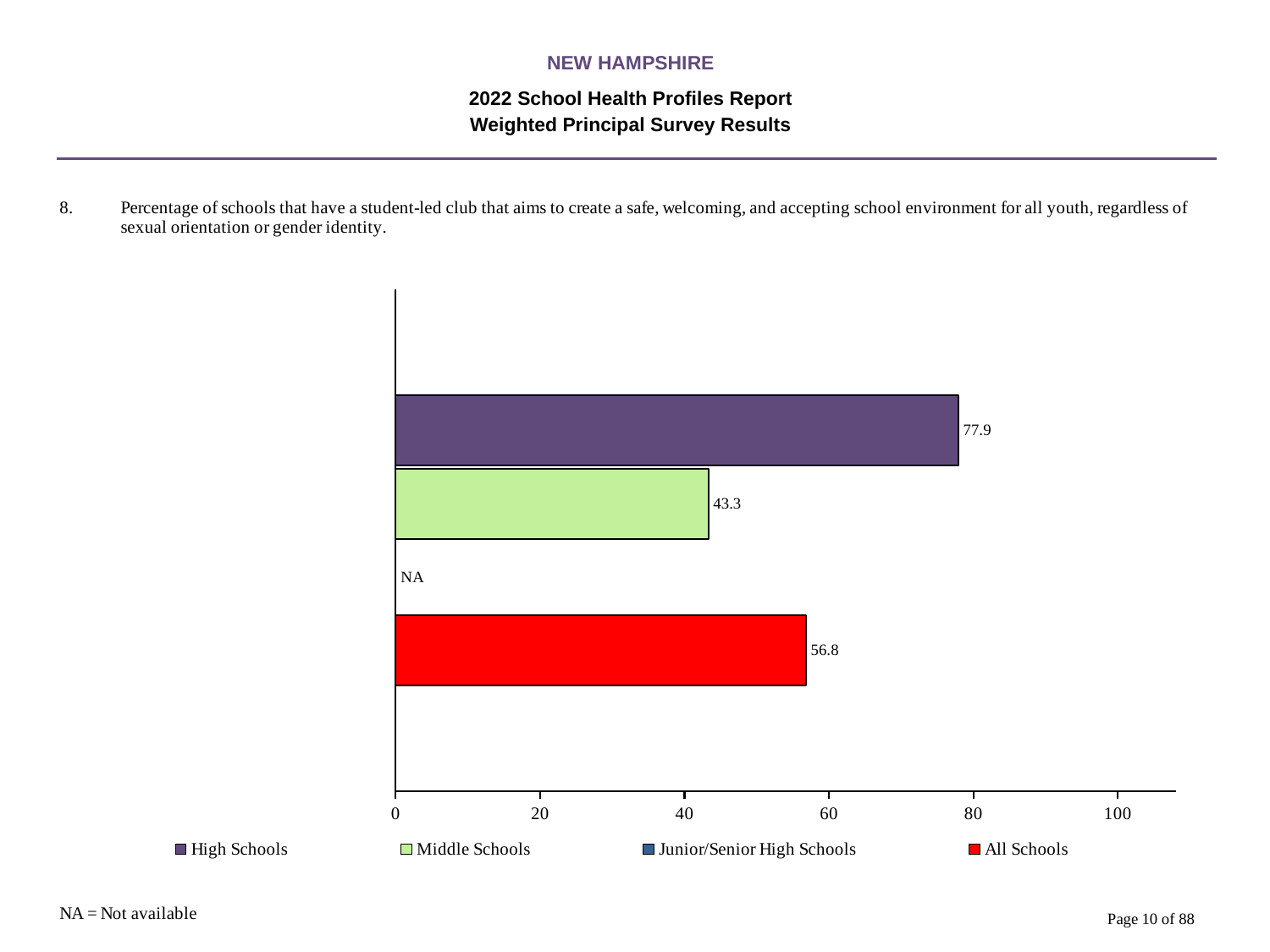
What is the difference between the All Schools value and the Middle Schools value? 13.5 How many series does the legend list? 4 Which series has the highest value? High Schools Which series with a plotted value has the lowest value? Middle Schools What is the value for All Schools? 56.8 What is the value for High Schools? 77.9 What is the difference between the High Schools value and the Middle Schools value? 34.6 What colour is the All Schools bar? Red What is shown for Junior/Senior High Schools? NA Which is larger, the value for High Schools or the value for All Schools? High Schools What kind of chart is shown? Bar chart What is the value for Middle Schools? 43.3